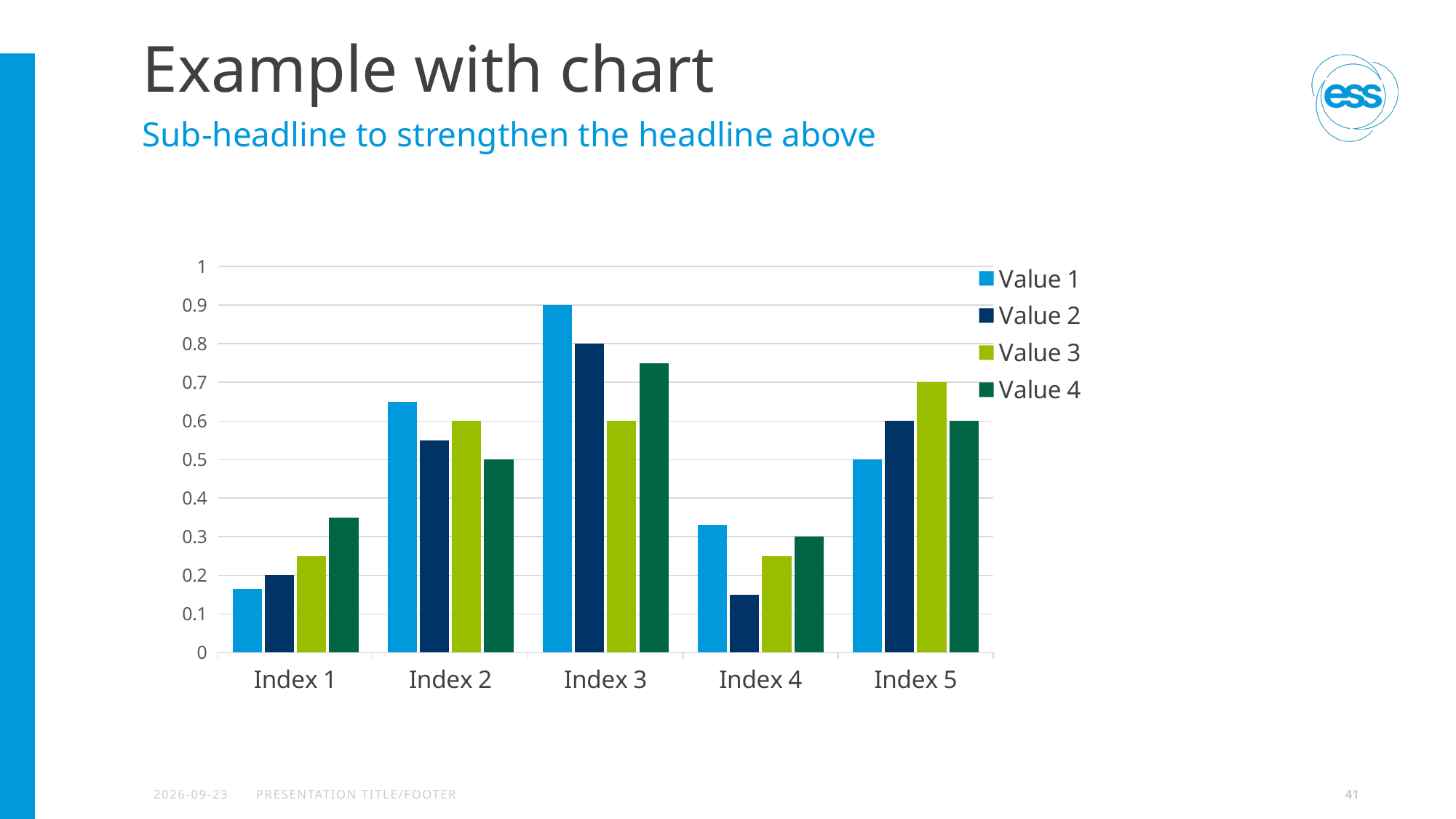
What kind of chart is shown on the slide? bar chart What is the value of Value 2 at Index 3? 0.8 Which category has the lowest Value 2 bar? Index 4 How many series does the legend list? 4 How many categories are shown on the x axis? 5 Is the value for Value 1 at Index 2 greater or less than 0.6? greater Which is larger at Index 4: Value 1 or Value 2? Value 1 Is the value for Value 4 at Index 1 greater or less than 0.4? less What is the value of Value 1 at Index 3? 0.9 What is the value of Value 4 at Index 2? 0.5 What is the value of Value 3 at Index 5? 0.7 Which category has the highest Value 1 bar? Index 3